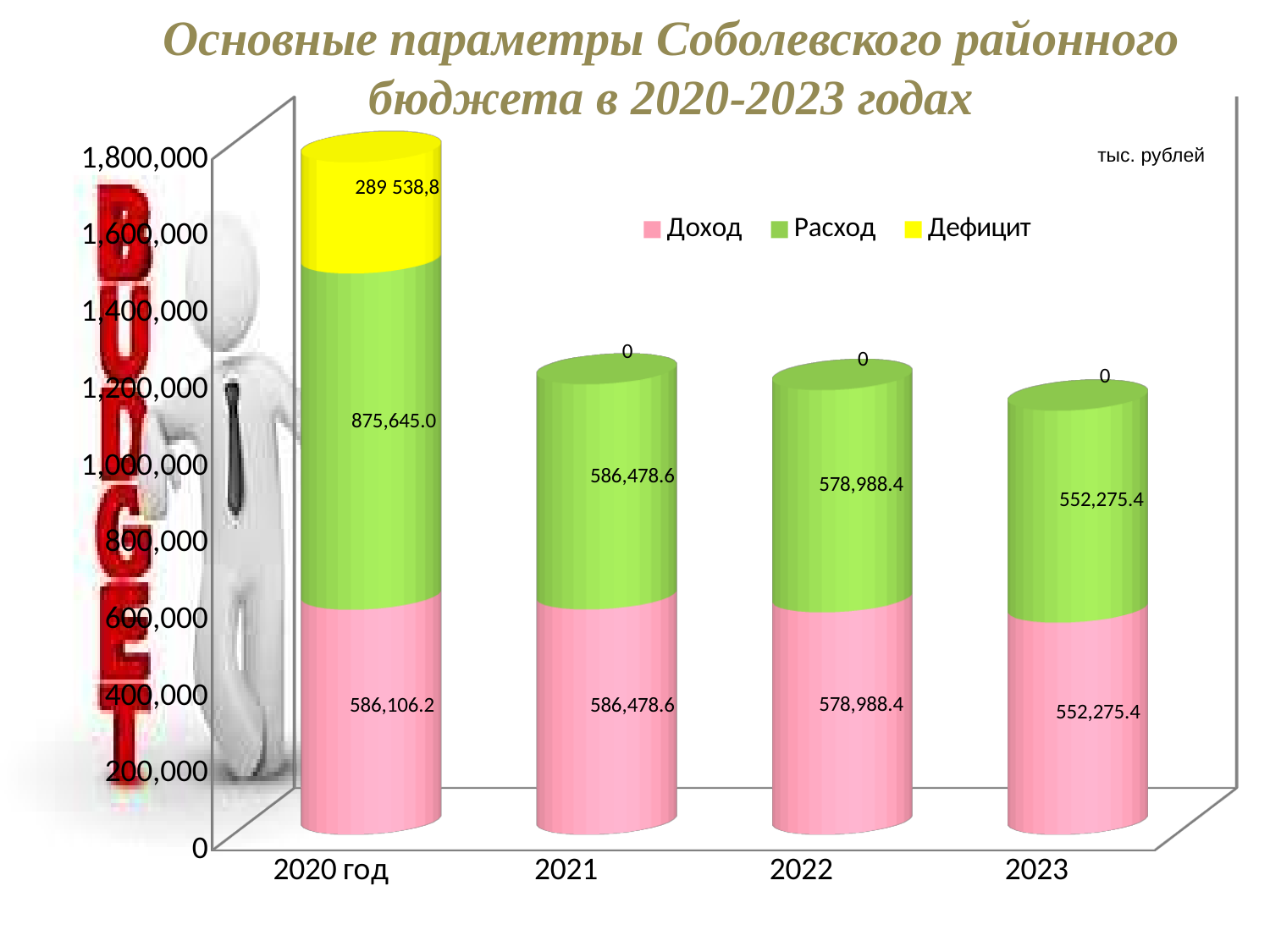
Which is larger: Расход in 2021 or Расход in 2022? Расход in 2021 What is the total of the stacked bar for 2021? 1,172,957.2 In which year is Расход the highest? 2020 год How many series does the legend list? 3 What is the value of Доход for 2023? 552,275.4 What is the value of Доход for 2020 год? 586,106.2 What is the value of Расход for 2020 год? 875,645.0 What is the value of Дефицит for 2022? 0 What is the value of Дефицит for 2020 год? 289 538,8 In which year is Доход the lowest? 2023 What is the difference between Расход and Доход in 2020 год? 289,538.8 What is the difference between Доход in 2021 and Доход in 2023? 34,203.2